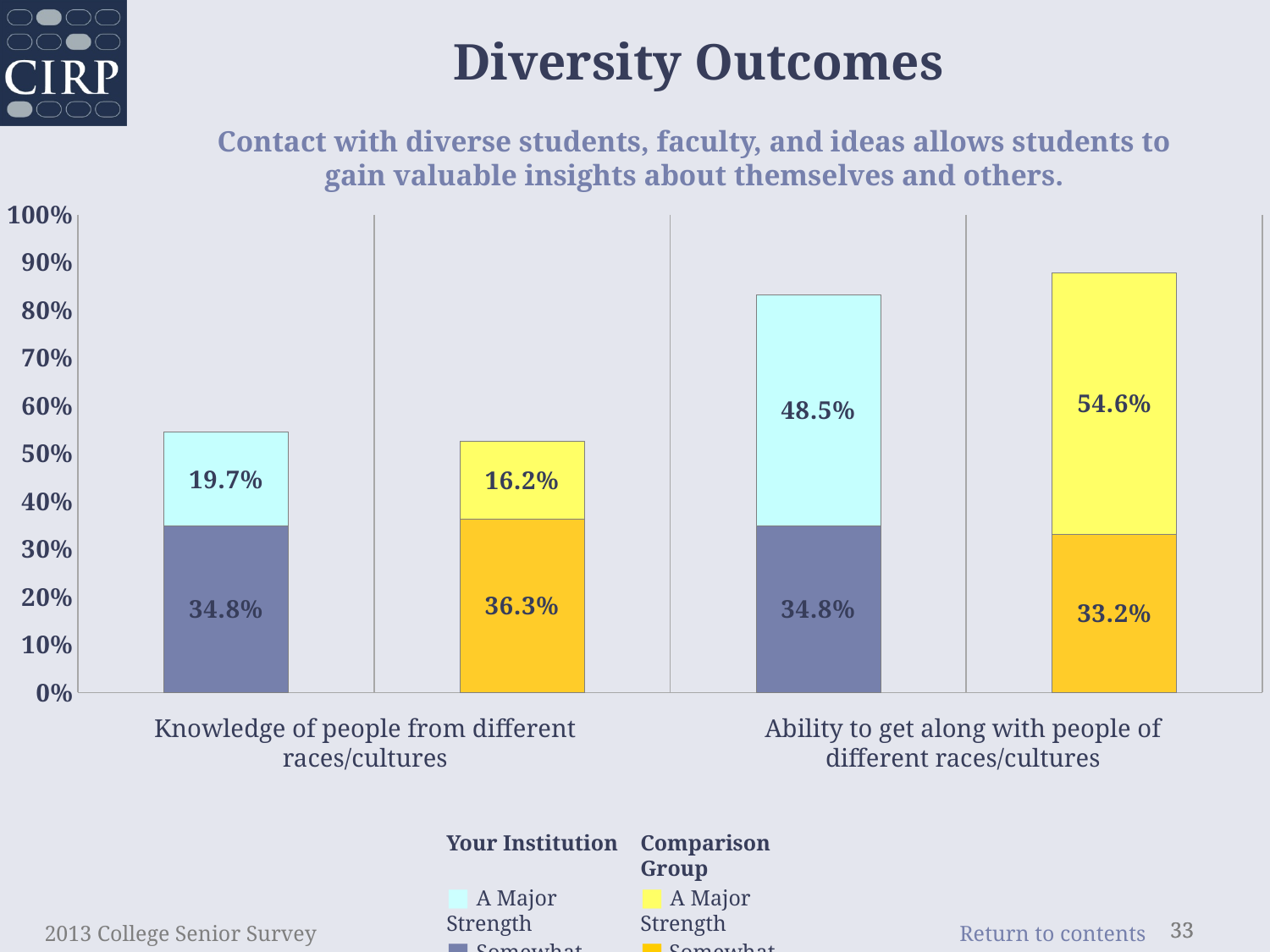
For 'Ability to get along with people of different races/cultures', how much higher is the Comparison Group's A Major Strength value than Your Institution's? 6.1 percentage points What percentage of the Comparison Group rated 'Ability to get along with people of different races/cultures' as A Major Strength? 54.6% What is the value of the bottom (blue-grey) segment of the Your Institution bar for 'Ability to get along with people of different races/cultures'? 34.8% What is the total height of the Comparison Group stacked bar for 'Ability to get along with people of different races/cultures'? 87.8% What is the value of the bottom (orange) segment of the Comparison Group bar for 'Knowledge of people from different races/cultures'? 36.3% How many outcome categories are shown on the x axis? 2 What is the total height of the Your Institution stacked bar for 'Ability to get along with people of different races/cultures'? 83.3% What percentage of Your Institution students rated 'Knowledge of people from different races/cultures' as A Major Strength? 19.7% What is the title of the slide containing the chart? Diversity Outcomes Which stacked bar is the tallest on the chart? Comparison Group, Ability to get along with people of different races/cultures For 'Knowledge of people from different races/cultures', which has the larger A Major Strength value: Your Institution or the Comparison Group? Your Institution What kind of chart is shown on the slide? Stacked bar chart